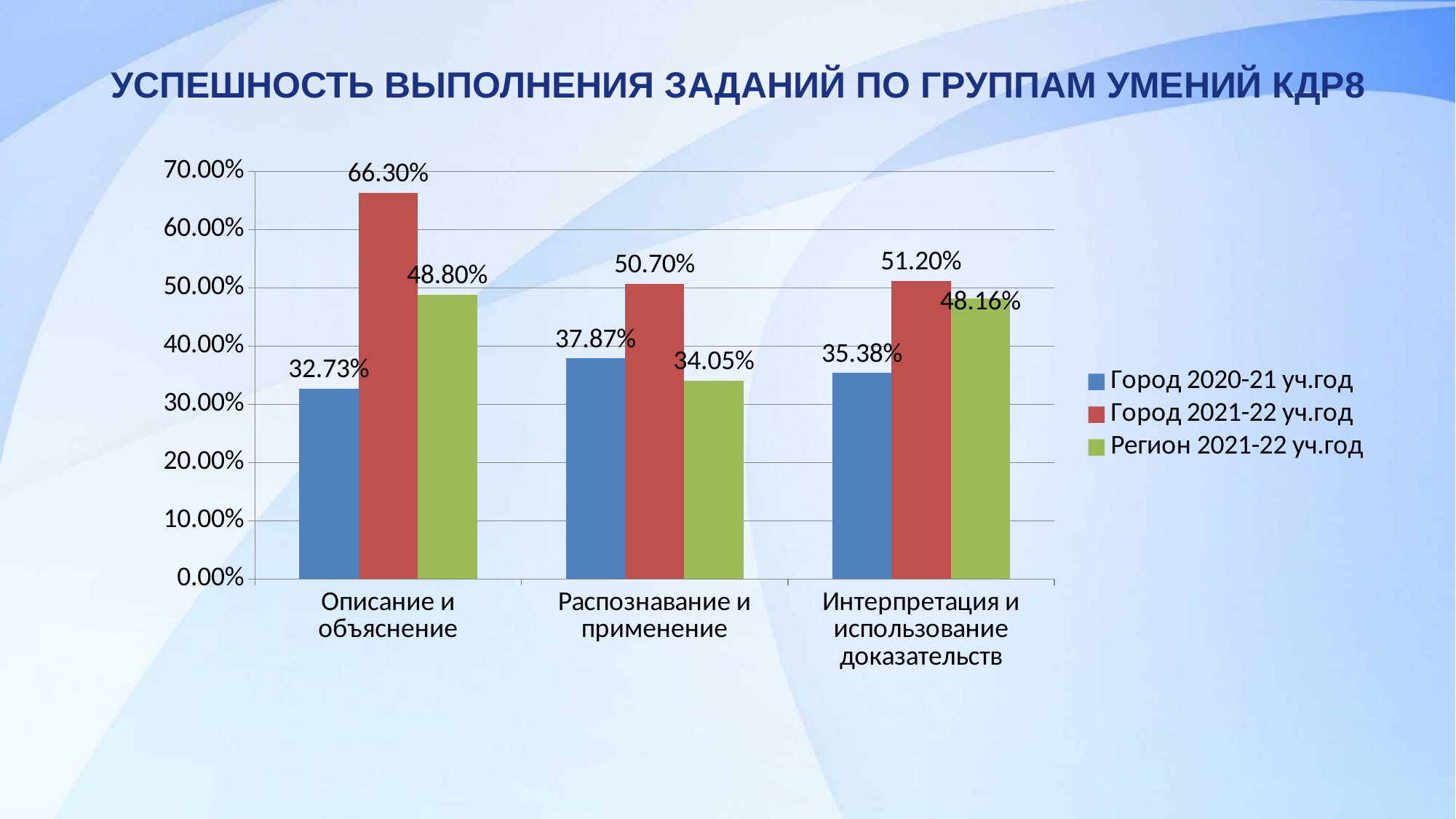
What is the value for Город 2021-22 уч.год in the category Описание и объяснение? 66.30% How many categories are shown on the x axis? 3 Which category has the lowest value for Город 2020-21 уч.год? Описание и объяснение What is the difference between Город 2021-22 уч.год and Город 2020-21 уч.год in the category Описание и объяснение? 33.57% Is the value for Регион 2021-22 уч.год in the category Описание и объяснение greater or less than 40.00%? greater What is the value for Регион 2021-22 уч.год in the category Распознавание и применение? 34.05% What kind of chart is shown on the slide? bar chart What is the title of the slide? УСПЕШНОСТЬ ВЫПОЛНЕНИЯ ЗАДАНИЙ ПО ГРУППАМ УМЕНИЙ КДР8 How many series does the legend list? 3 What is the value for Город 2020-21 уч.год in the category Интерпретация и использование доказательств? 35.38% Which is larger in the category Интерпретация и использование доказательств: Город 2021-22 уч.год or Регион 2021-22 уч.год? Город 2021-22 уч.год Which category has the highest value for Город 2021-22 уч.год? Описание и объяснение